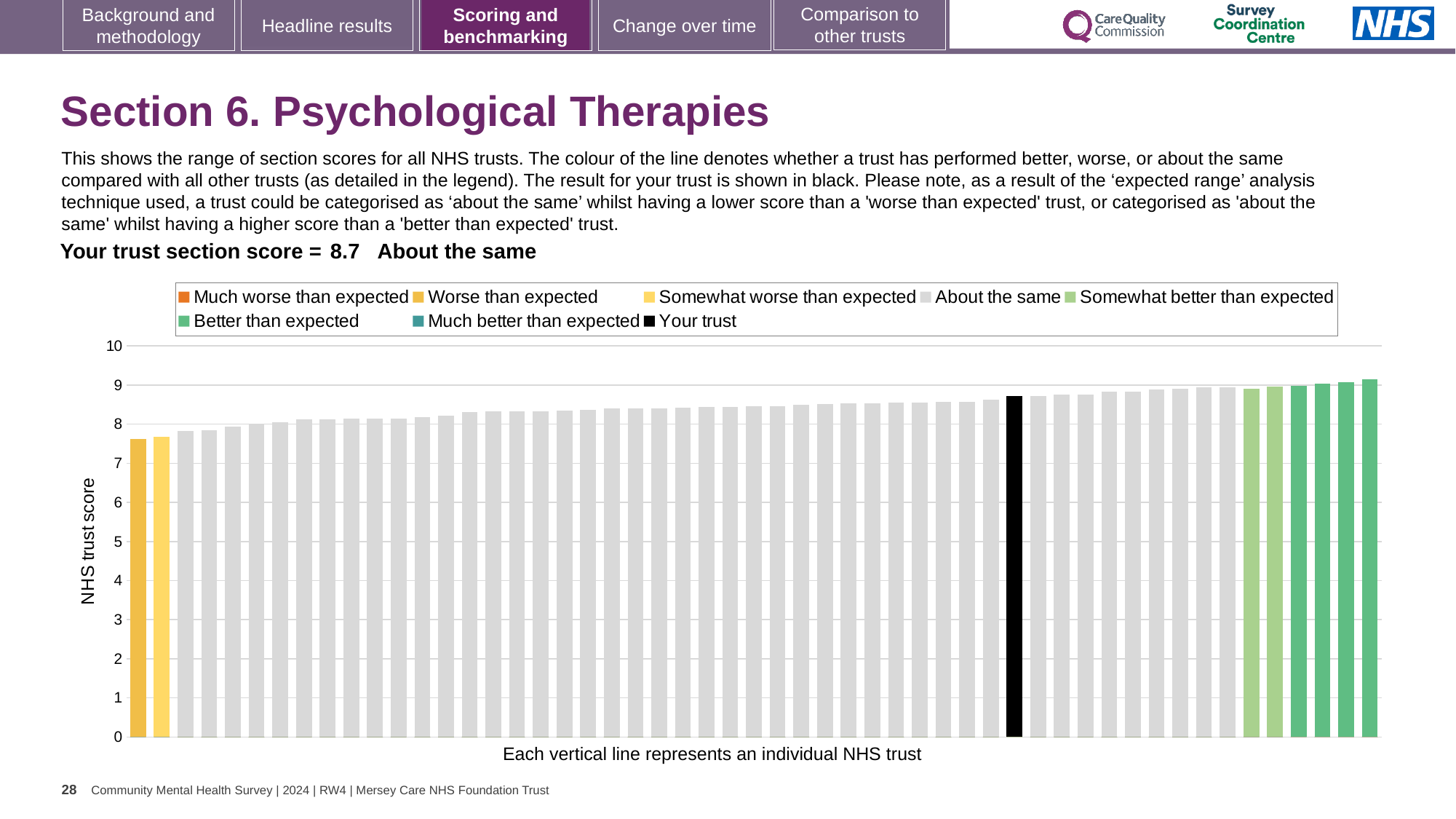
Do the bar values rise or fall from left to right along the x axis? rise Which legend category does the lowest bar belong to? Worse than expected Which performance category is the trust's section score placed in? About the same Which legend category does the highest bar belong to? Better than expected Is the value of the black 'Your trust' bar greater or less than 8? greater Is the value of the rightmost bar greater or less than 9? greater Is the value of the black 'Your trust' bar greater or less than 9? less What kind of chart is shown on the slide? bar chart What is the trust's section score for Psychological Therapies? 8.7 What is the label on the vertical axis? NHS trust score How many entries does the chart legend list? 8